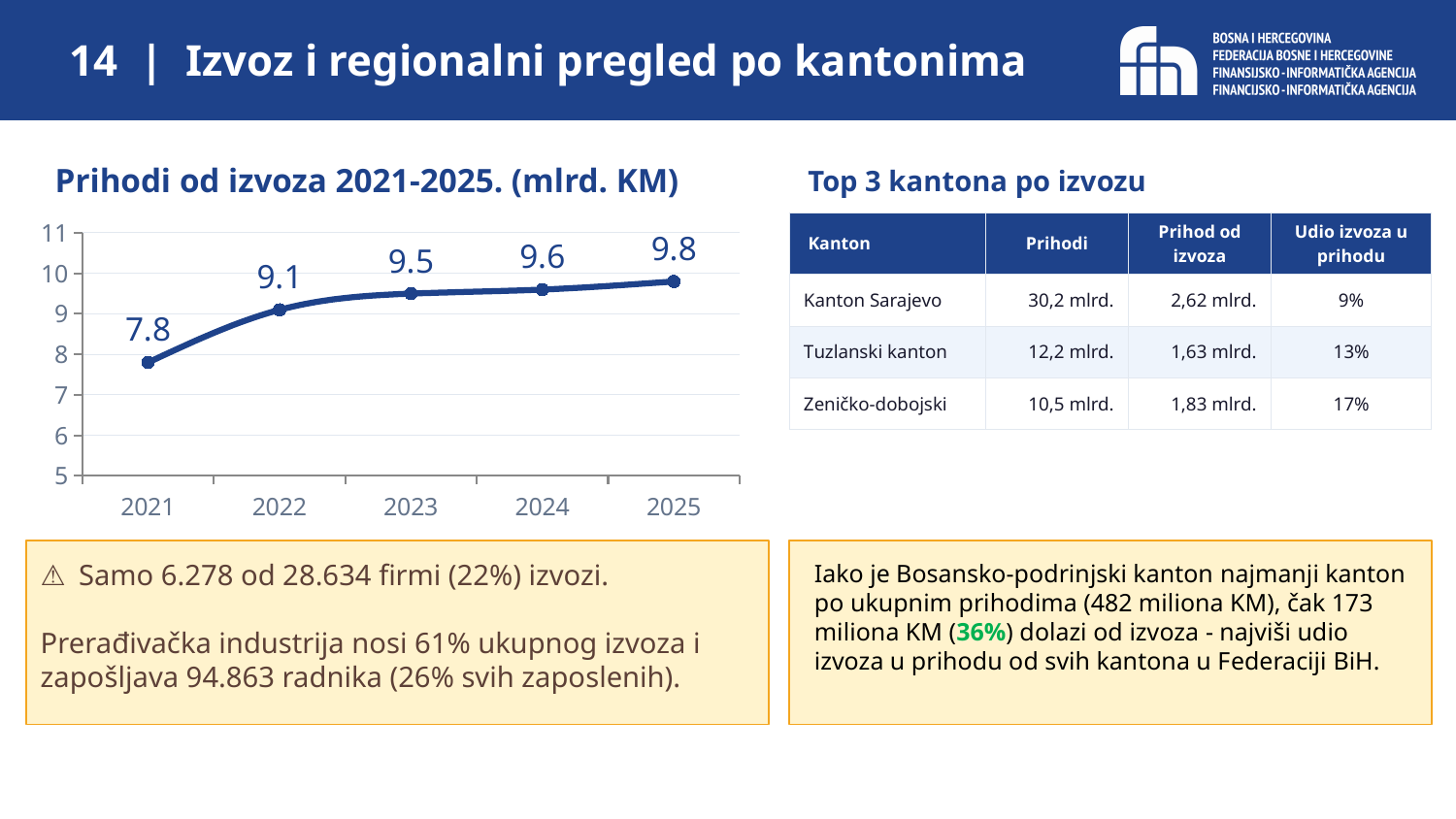
How many years (data points) are plotted in the line chart? 5 What is the difference between the export revenue values for 2025 and 2021 in the line chart? 2.0 What is the difference between the export revenue values for 2022 and 2021 in the line chart? 1.3 What is the export revenue value shown for 2023 in the line chart? 9.5 What is the export revenue value shown for 2021 in the 'Prihodi od izvoza 2021-2025. (mlrd. KM)' chart? 7.8 In the line chart, is the export revenue for 2024 larger or smaller than for 2022? larger Which year has the lowest export revenue in the line chart? 2021 What is the export revenue value shown for 2025 in the line chart? 9.8 Which year has the highest export revenue in the line chart? 2025 Do the export revenue values in the line chart rise or fall from 2021 to 2025? rise What type of chart is used to show 'Prihodi od izvoza 2021-2025. (mlrd. KM)'? line chart Is the export revenue value for 2021 in the line chart greater or less than 8? less